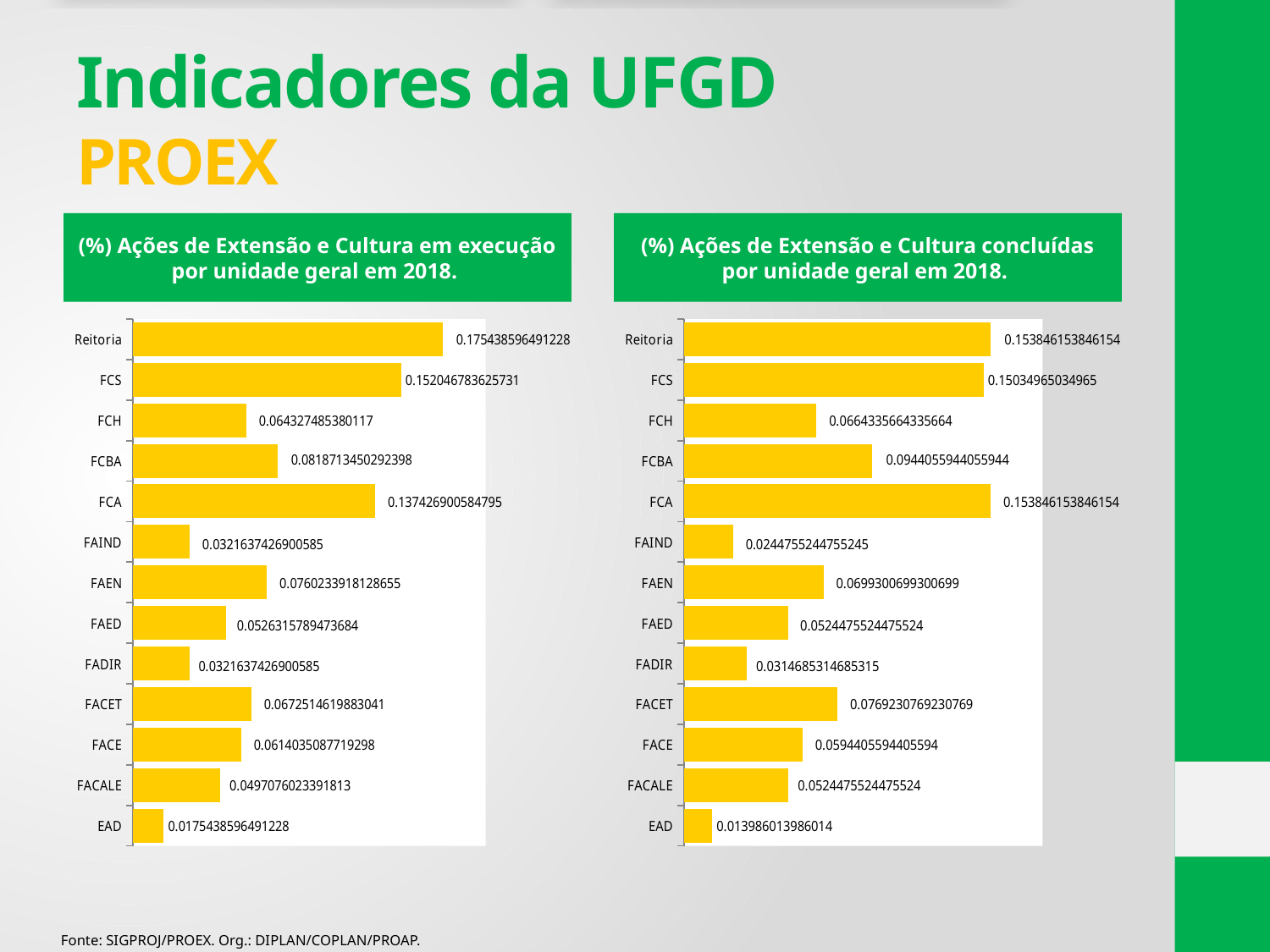
In the right chart (concluídas), what is the value for FCBA? 0.0944055944055944 In the left chart (em execução), which unit has the lowest value? EAD In the left chart (em execução), what is the value for Reitoria? 0.175438596491228 What kind of chart is the right chart (concluídas)? Bar chart How many units are shown in the left chart (em execução)? 13 In the right chart (concluídas), which unit has the lowest value? EAD What is the title of the left chart? (%) Ações de Extensão e Cultura em execução por unidade geral em 2018. In the left chart (em execução), which unit has the highest value? Reitoria In the left chart (em execução), what is the value for FAEN? 0.0760233918128655 In the right chart (concluídas), what is the value for EAD? 0.013986013986014 In the right chart (concluídas), which is larger, the value for FCBA or the value for FAEN? FCBA In the left chart (em execução), what is the difference between the values for Reitoria and FCS? 0.023391812865497